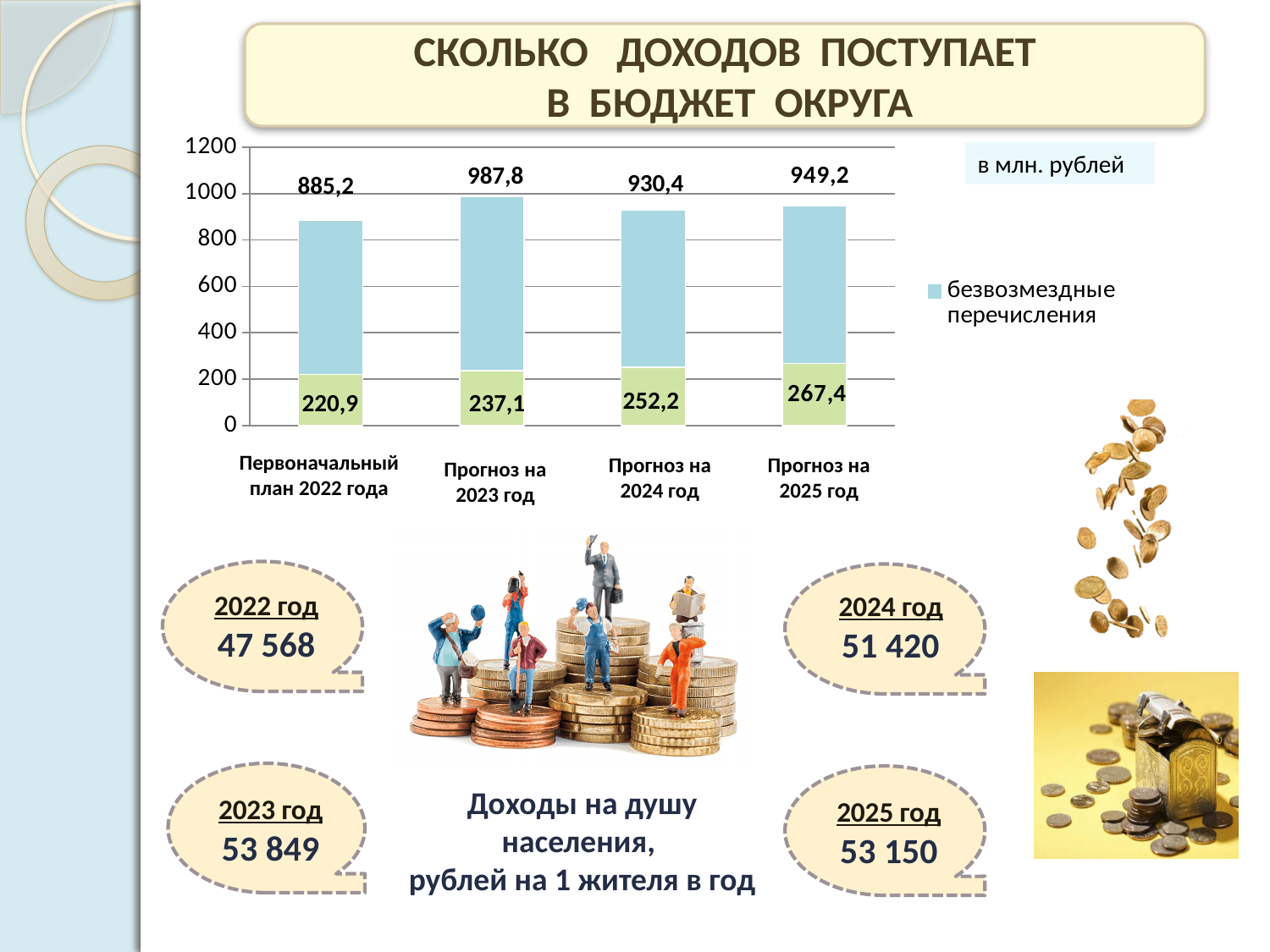
What is the difference between the green segment values for Прогноз на 2025 год (267,4) and Первоначальный план 2022 года (220,9)? 46,5 What value is printed on the green segment for Прогноз на 2024 год? 252,2 Which category has the lowest value printed above its bar? Первоначальный план 2022 года Which category has the largest green segment value? Прогноз на 2025 год What unit is stated for the chart values? в млн. рублей Which is larger: the value above the bar for Прогноз на 2024 год or for Прогноз на 2025 год? Прогноз на 2025 год What kind of chart is shown on the slide? bar chart What value is printed above the bar for Прогноз на 2023 год? 987,8 How many categories are shown on the x axis of the chart? 4 Which category has the highest value printed above its bar? Прогноз на 2023 год What is the difference between the values printed above the bars for Прогноз на 2023 год (987,8) and Первоначальный план 2022 года (885,2)? 102,6 Do the green segment values rise or fall from left to right along the x axis? rise